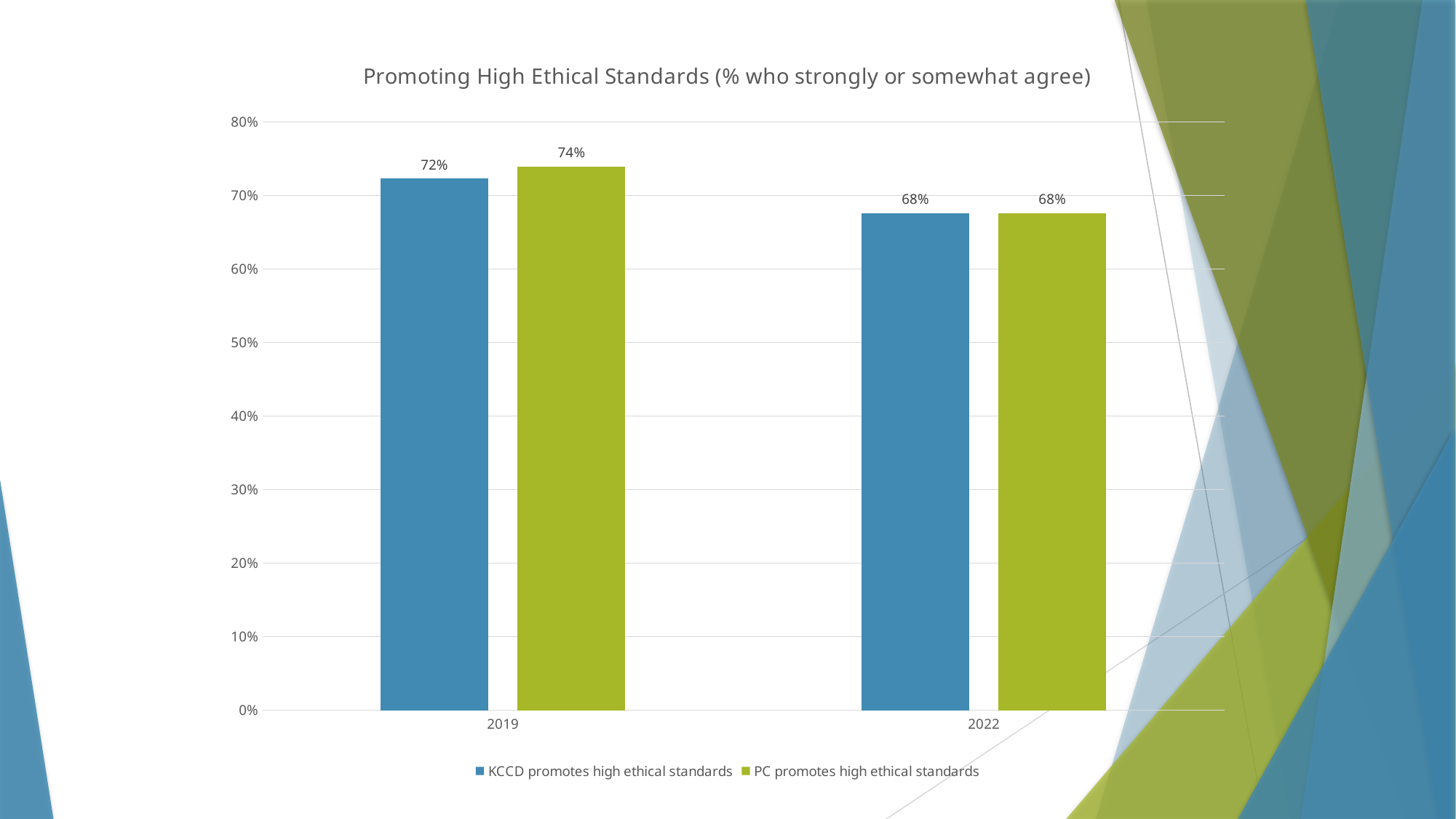
What is the value for 'KCCD promotes high ethical standards' in 2019? 72% What is the value for 'PC promotes high ethical standards' in 2019? 74% What is the value for 'KCCD promotes high ethical standards' in 2022? 68% What is the value for 'PC promotes high ethical standards' in 2022? 68% Which year has the highest value for 'PC promotes high ethical standards'? 2019 Do the values for 'KCCD promotes high ethical standards' rise or fall from 2019 to 2022? Fall How many series does the legend list? 2 How many years are shown on the x axis? 2 What is the difference between the 2019 and 2022 values for 'KCCD promotes high ethical standards'? 4% Which year has the lowest value for 'KCCD promotes high ethical standards'? 2022 What kind of chart is shown on the slide? Bar chart What is the difference between the 2019 and 2022 values for 'PC promotes high ethical standards'? 6%